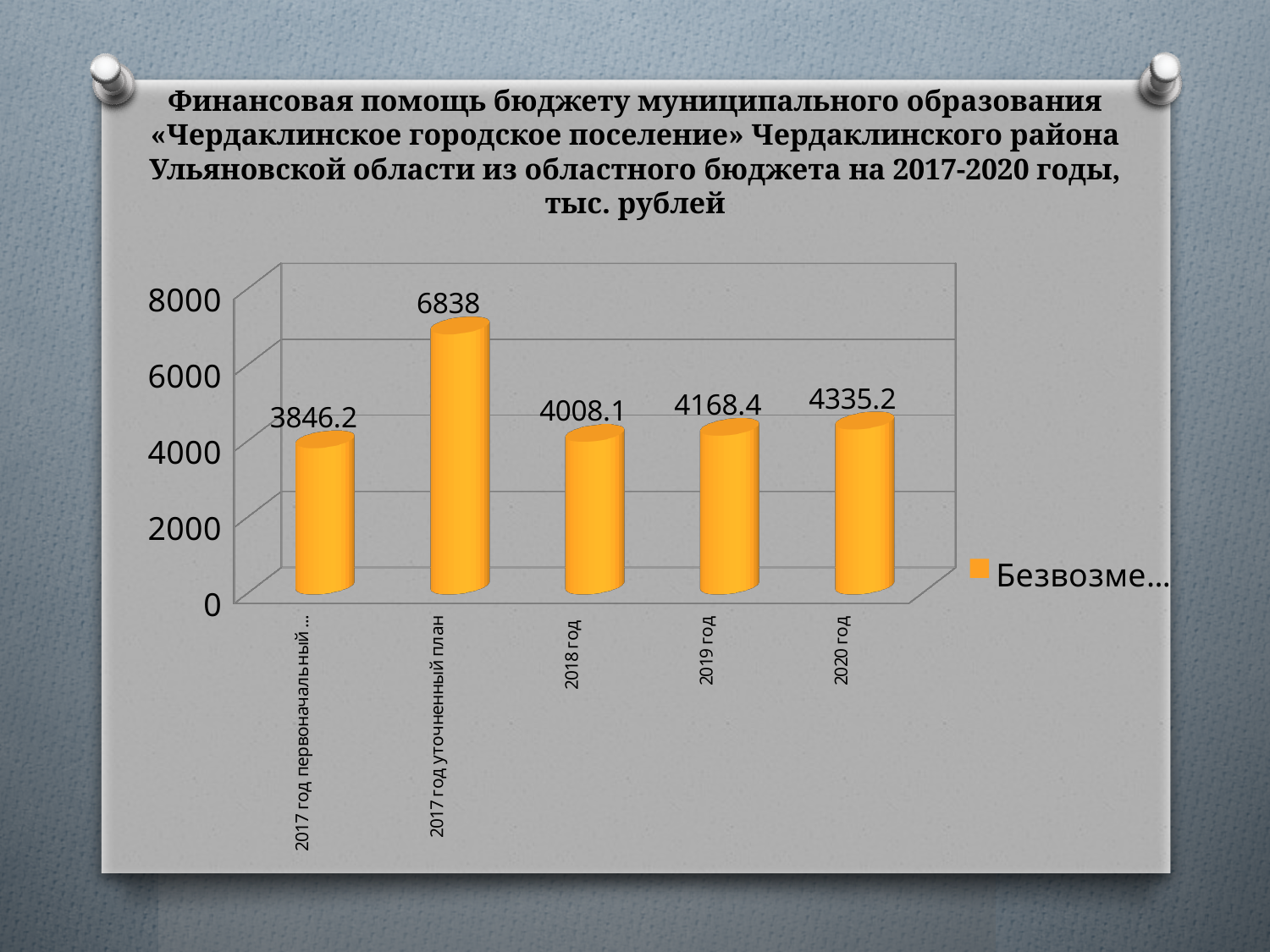
How many bars (categories) are shown in the chart? 5 What is the value for «2017 год уточненный план»? 6838 What is the value of the leftmost bar (2017 год первоначальный ...)? 3846.2 What is the difference between the values for «2020 год» and «2018 год»? 327.1 What is the value for «2019 год»? 4168.4 Which category has the lowest value? The leftmost bar, 2017 год первоначальный ... What kind of chart is shown on the slide? Bar chart What is the value for «2020 год»? 4335.2 Which category has the highest value? 2017 год уточненный план What is the value for «2018 год»? 4008.1 Do the values rise or fall from «2018 год» to «2020 год»? Rise Which is larger, the value for «2019 год» or for «2018 год»? 2019 год